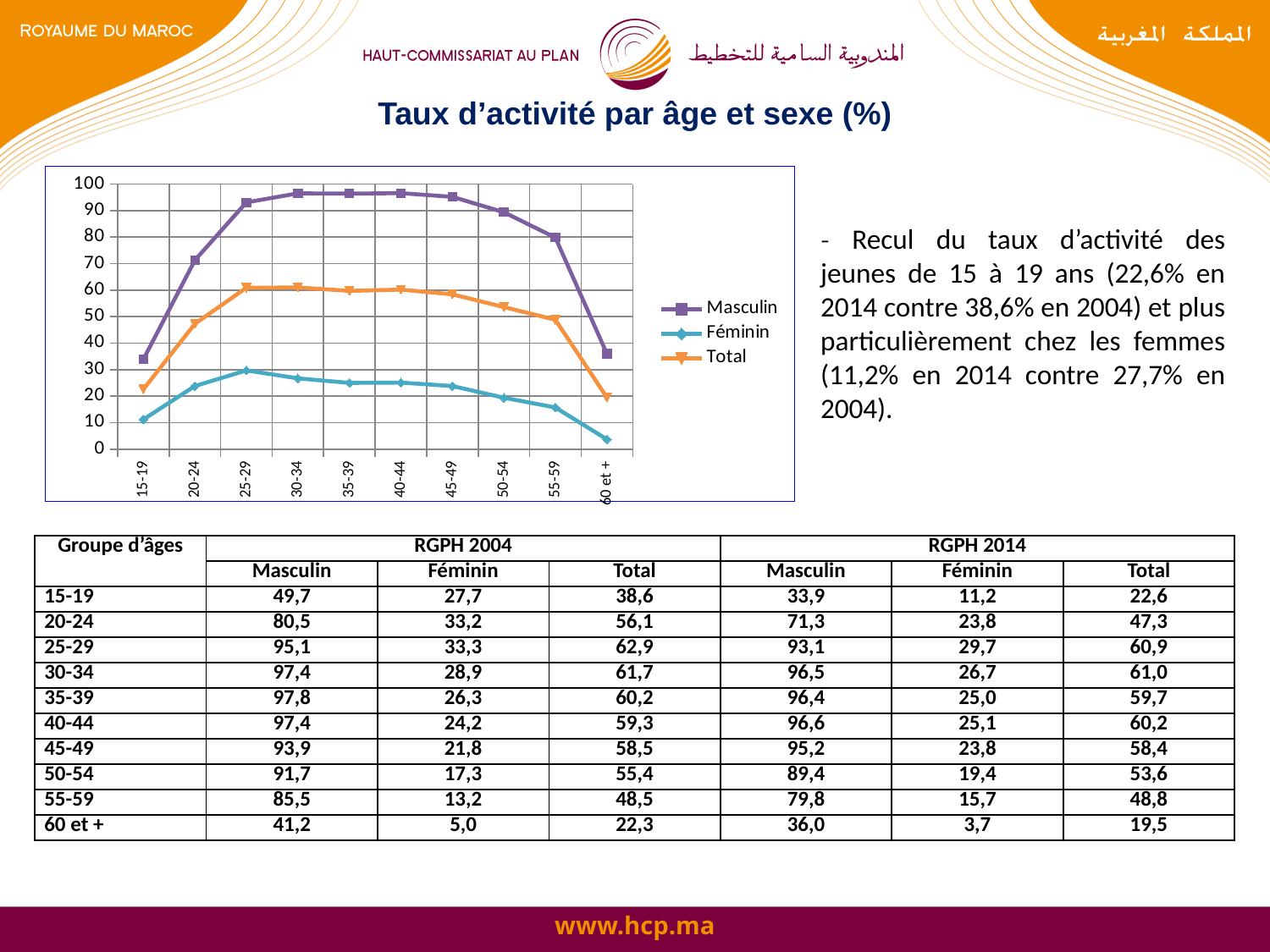
Is the Féminin value for the 55-59 age group greater or less than 20? less Is the Masculin value for the 15-19 age group greater or less than 40? less Which is larger for the 40-44 age group, the Masculin value or the Féminin value? Masculin Which series are listed in the chart legend? Masculin, Féminin, Total Is the Total value for the 20-24 age group greater or less than 50? less For which age group is the Féminin series lowest? 60 et + What kind of chart is shown on the slide? line chart Does the Masculin series rise or fall from the 15-19 age group to the 25-29 age group? rise How many age groups are plotted along the x axis of the chart? 10 How many series does the chart legend list? 3 Does the Masculin series rise or fall from the 45-49 age group to the 60 et + age group? fall What is the title of the slide's chart? Taux d’activité par âge et sexe (%)